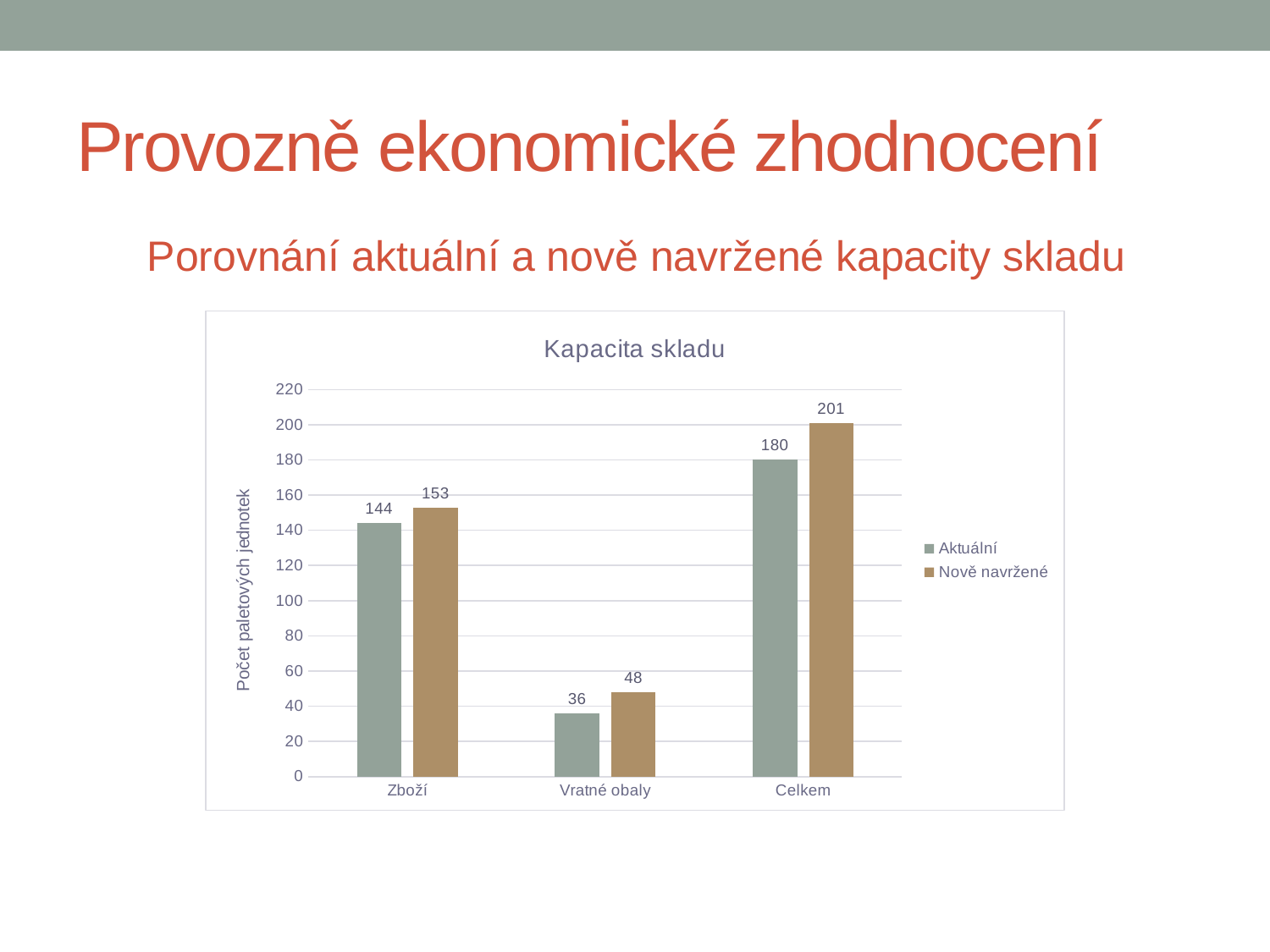
What is the difference between the Nově navržené and Aktuální values for Zboží? 9 How many series does the legend list? 2 What is the Nově navržené value for Vratné obaly? 48 What is the difference between the Nově navržené and Aktuální values for Celkem? 21 Which category has the lowest Nově navržené value? Vratné obaly How many categories are shown on the x axis? 3 Which category has the highest Aktuální value? Celkem Which is larger for Vratné obaly: the Aktuální value or the Nově navržené value? Nově navržené What is the Nově navržené value for Celkem? 201 What is the Aktuální value for Zboží? 144 What is the title of the chart? Kapacita skladu What kind of chart is shown? bar chart